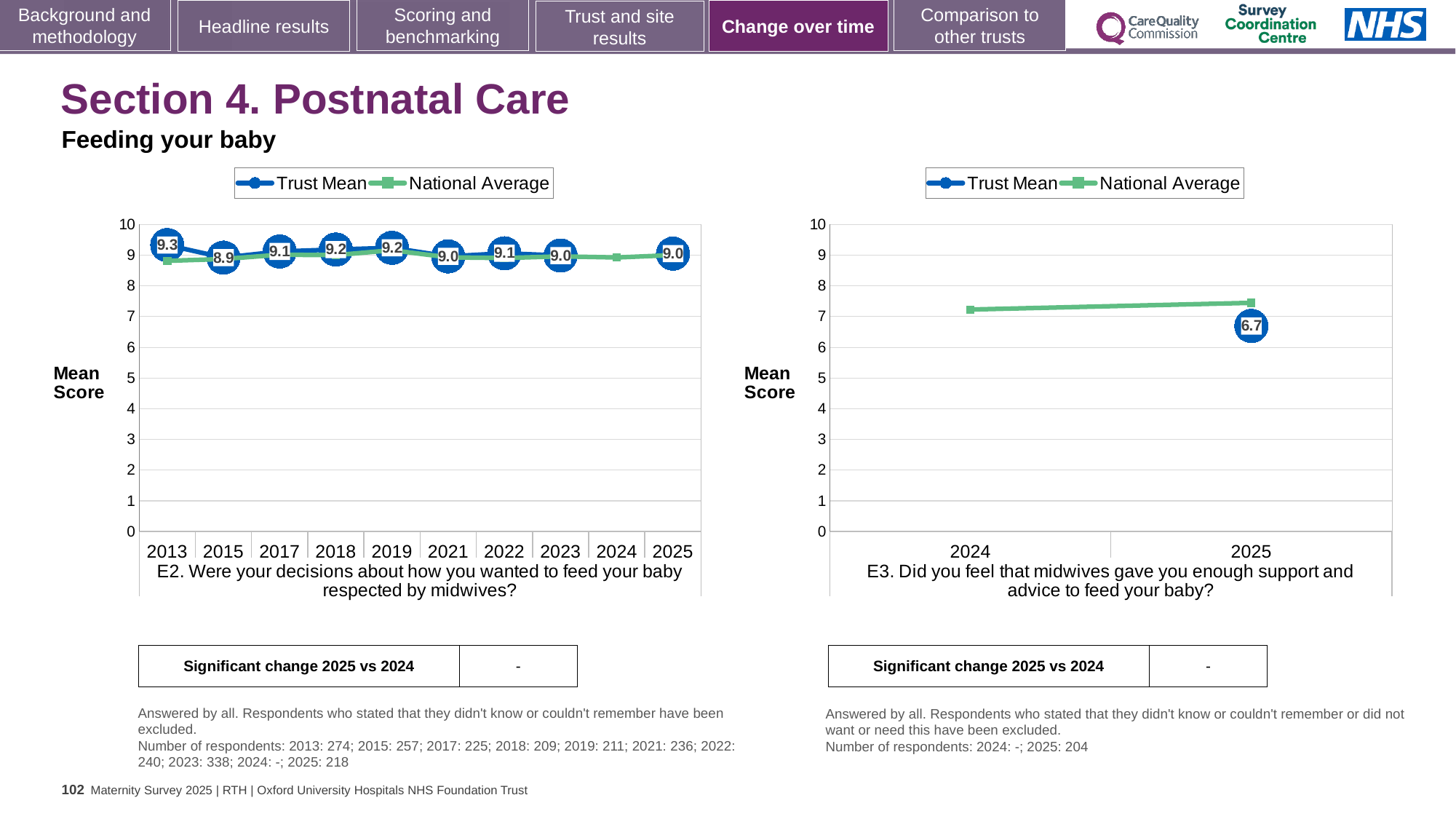
How many years are shown on the x axis of the E2 chart (left)? 10 What type of chart is the E2 chart (left)? Line chart In the E3 chart (right), is the National Average value for 2024 greater or less than 8? less In the E3 chart (right), what is the Trust Mean score for 2025? 6.7 In the E2 chart (left), what is the Trust Mean score for 2025? 9.0 In the E3 chart (right), does the National Average rise or fall from 2024 to 2025? Rise In the E2 chart (left), is the Trust Mean score higher in 2018 or in 2021? 2018 In the E2 chart (left), which year has the highest Trust Mean score? 2013 In the E2 chart (left), which year has the lowest Trust Mean score? 2015 How many series does the legend of the E3 chart (right) list? 2 In the E2 chart (left), what is the Trust Mean score for 2013? 9.3 In the E2 chart (left), what is the difference between the Trust Mean scores for 2013 and 2015? 0.4